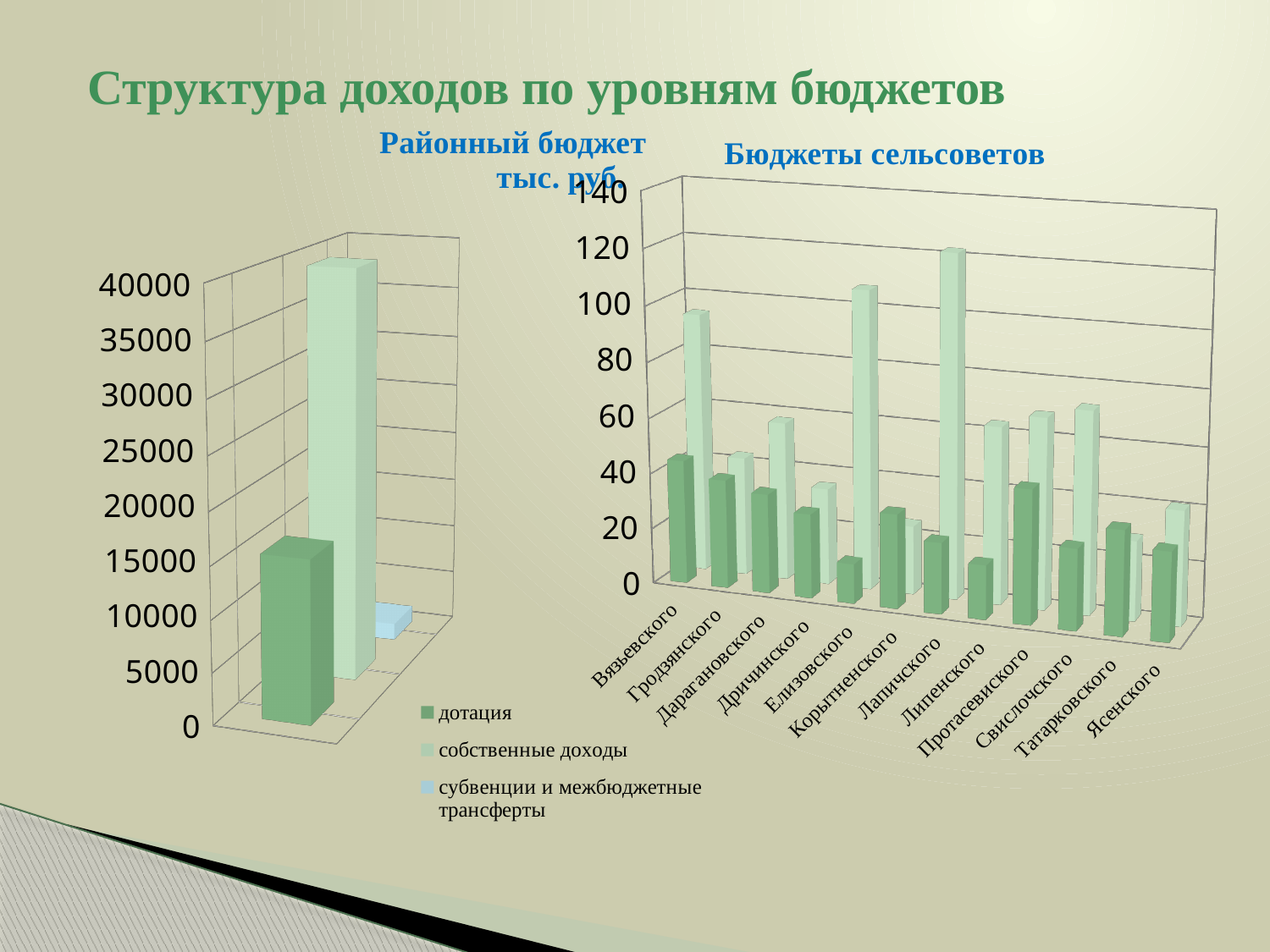
In the 'Районный бюджет' chart, is the value for дотация greater or less than 10000? greater In the 'Районный бюджет' chart, which series has the lowest value? субвенции и межбюджетные трансферты How many series does the legend on the slide list? 3 In the 'Районный бюджет' chart, is the value for собственные доходы greater or less than 35000? greater What kind of chart is the 'Бюджеты сельсоветов' chart? bar chart In the 'Бюджеты сельсоветов' chart, which сельсовет has the highest дотация? Протасевиского In the 'Бюджеты сельсоветов' chart, is the собственные доходы value for Липенского greater or less than 100? less In the 'Бюджеты сельсоветов' chart, which is larger: собственные доходы for Липенского or for Елизовского? Елизовского What is the title of the chart on the left of the slide? Районный бюджет тыс. руб. In the 'Районный бюджет' chart, which series has the highest value? собственные доходы In the 'Бюджеты сельсоветов' chart, which сельсовет has the highest собственные доходы? Лапичского How many categories (сельсоветы) are shown on the x axis of the 'Бюджеты сельсоветов' chart? 12